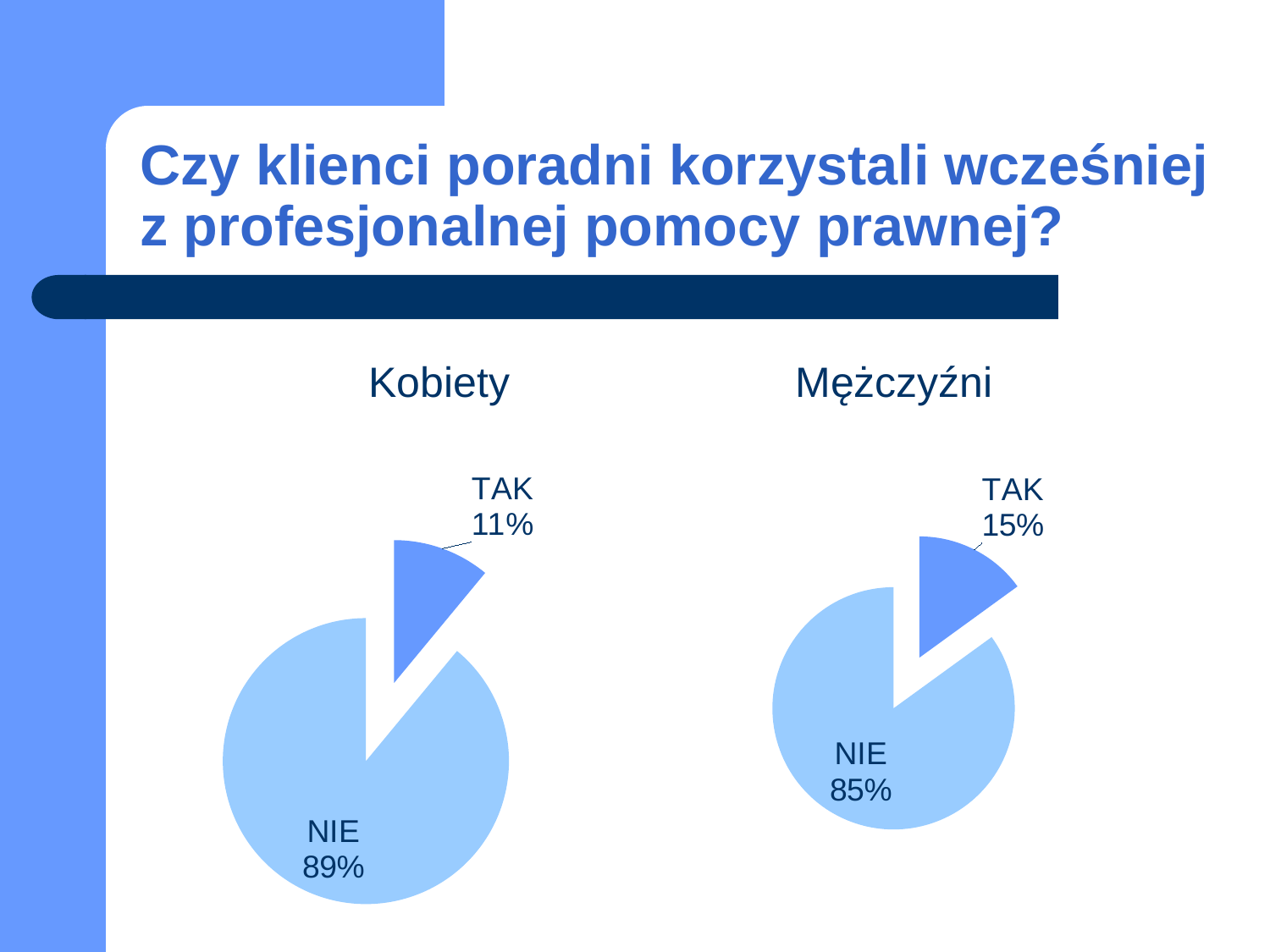
In the Kobiety chart, which slice is the largest? NIE What is the title of the chart on the right? Mężczyźni What is the difference between the TAK share in the Mężczyźni chart and the TAK share in the Kobiety chart? 4% How many slices does the Kobiety chart have? 2 In the Mężczyźni chart, what percentage is labelled TAK? 15% In the Mężczyźni chart, which slice is the smallest? TAK Which chart has the larger TAK share, Kobiety or Mężczyźni? Mężczyźni What type of chart is used for Mężczyźni? Pie chart In the Kobiety chart, what percentage is labelled TAK? 11% What is the difference between the NIE and TAK shares in the Kobiety chart? 78% In the Mężczyźni chart, what percentage is labelled NIE? 85% In the Kobiety chart, what percentage is labelled NIE? 89%